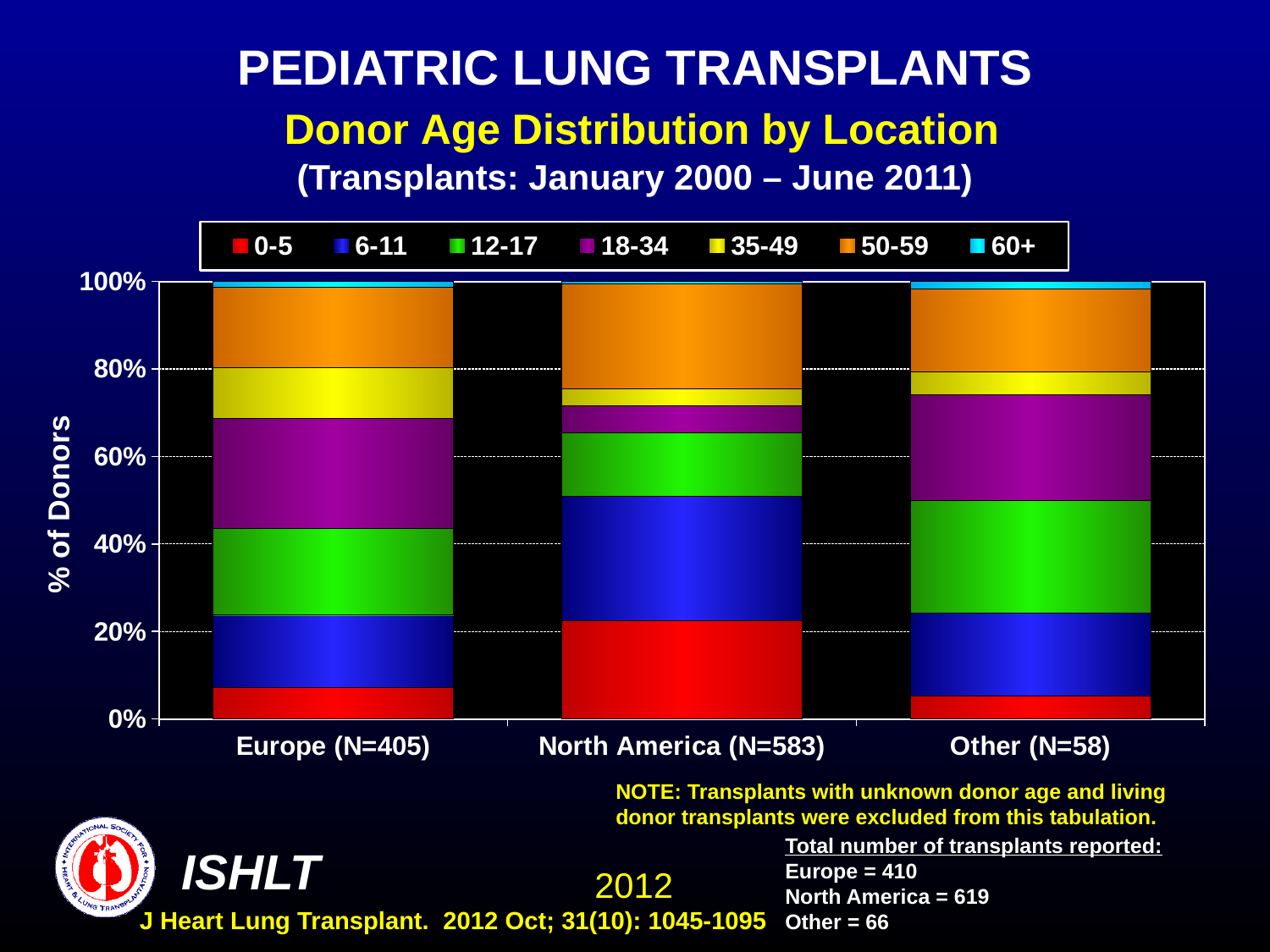
How many donor age groups does the legend list? 7 Is the share of 0-5 year old donors for North America greater or less than 20%? greater Which location has the largest share of 0-5 year old donors? North America (N=583) What is the label on the y axis? % of Donors Which has the larger share of 6-11 year old donors, North America or Europe? North America What kind of chart is shown on the slide? stacked bar chart How many locations (categories) are shown on the x axis? 3 Which has the larger share of 18-34 year old donors, Europe or North America? Europe What is the N shown in the x-axis label for North America? 583 Is the share of 0-5 year old donors for Other greater or less than 20%? less Is the share of 0-5 year old donors for Europe greater or less than 20%? less Which has the larger share of 12-17 year old donors, Other or North America? Other